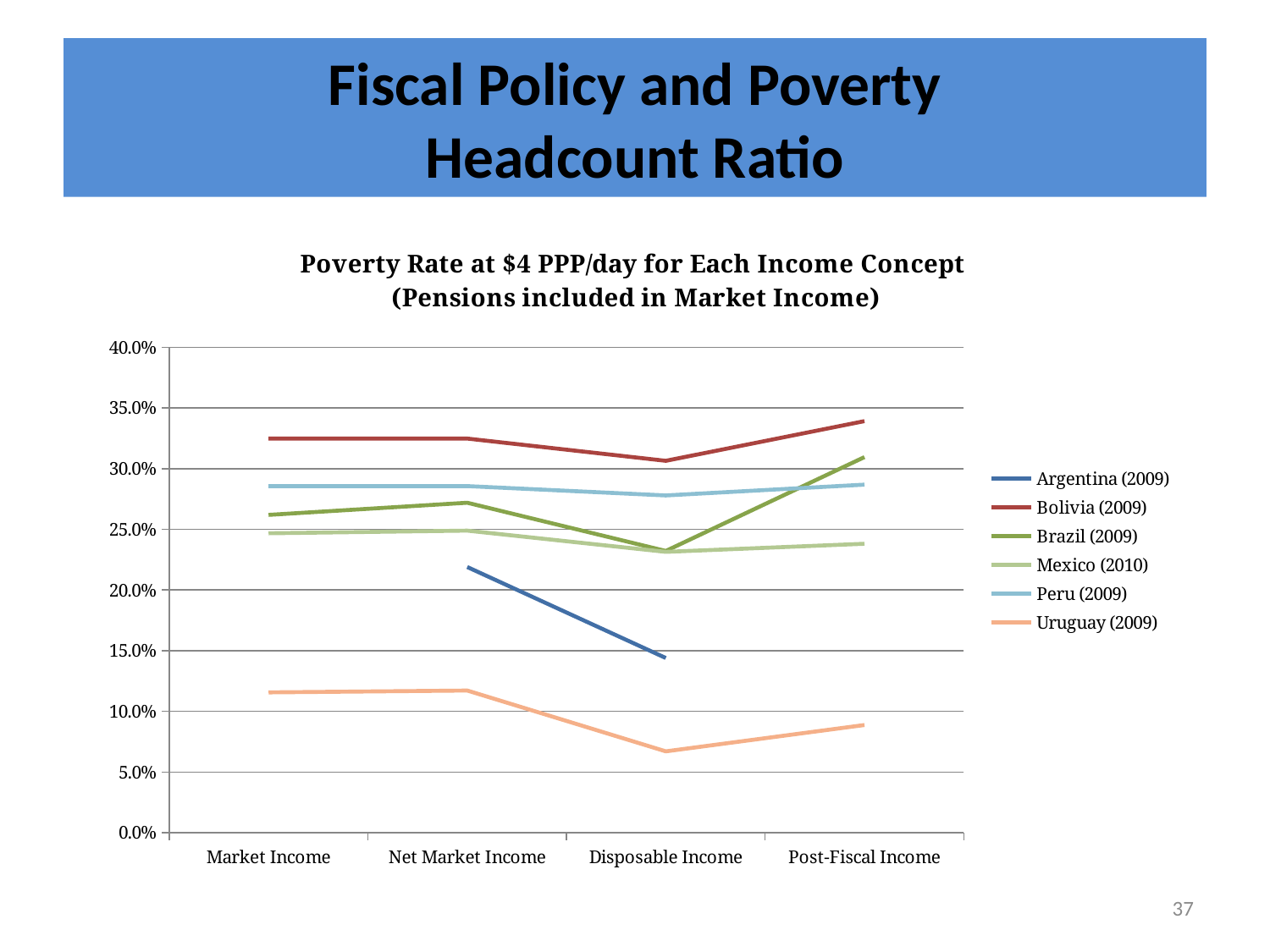
Is the value for Uruguay (2009) at Disposable Income greater or less than 10.0%? less Which country has the highest poverty rate at Market Income? Bolivia (2009) At Market Income, which is higher: Peru (2009) or Mexico (2010)? Peru (2009) Which country has the lowest poverty rate at Disposable Income? Uruguay (2009) Does the Argentina (2009) line rise or fall from Net Market Income to Disposable Income? fall At Post-Fiscal Income, which is higher: Brazil (2009) or Peru (2009)? Brazil (2009) Is the value for Argentina (2009) at Net Market Income greater or less than 20.0%? greater How many income concepts are shown along the x axis? 4 What type of chart is shown on the slide? line chart Is the value for Bolivia (2009) at Post-Fiscal Income greater or less than 30.0%? greater How many series does the legend list? 6 What is the title of the chart? Poverty Rate at $4 PPP/day for Each Income Concept (Pensions included in Market Income)